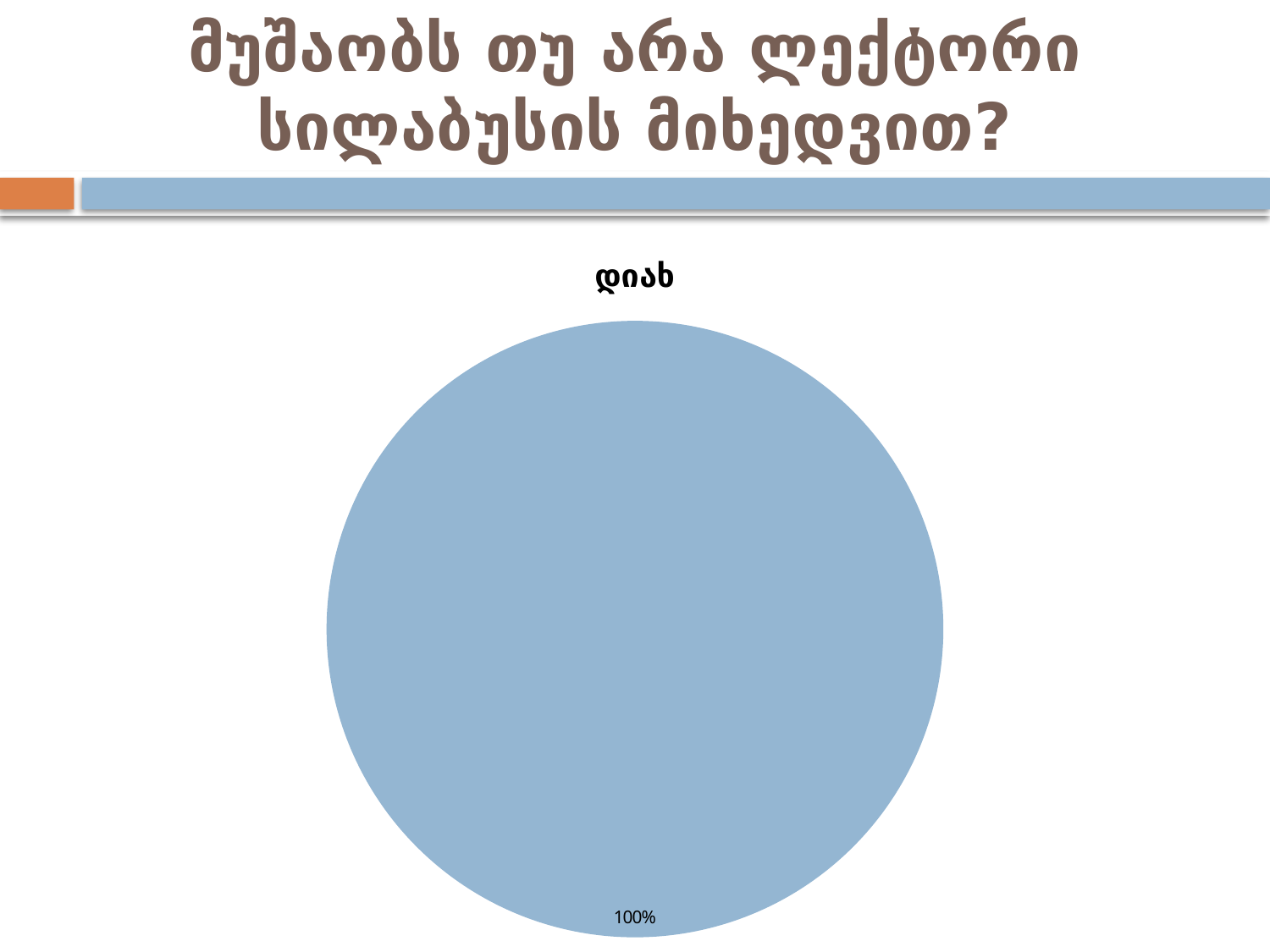
Is the value shown on the pie chart greater or less than 50%? greater What is the title of the slide? მუშაობს თუ არა ლექტორი სილაბუსის მიხედვით? What kind of chart is shown on the slide? pie chart How many slices does the pie chart have? 1 What share of the pie does the slice labelled 100% represent? 100% What colour is the pie chart slice? light blue What value is printed as the data label on the pie chart? 100% What is the title of the chart? დიახ